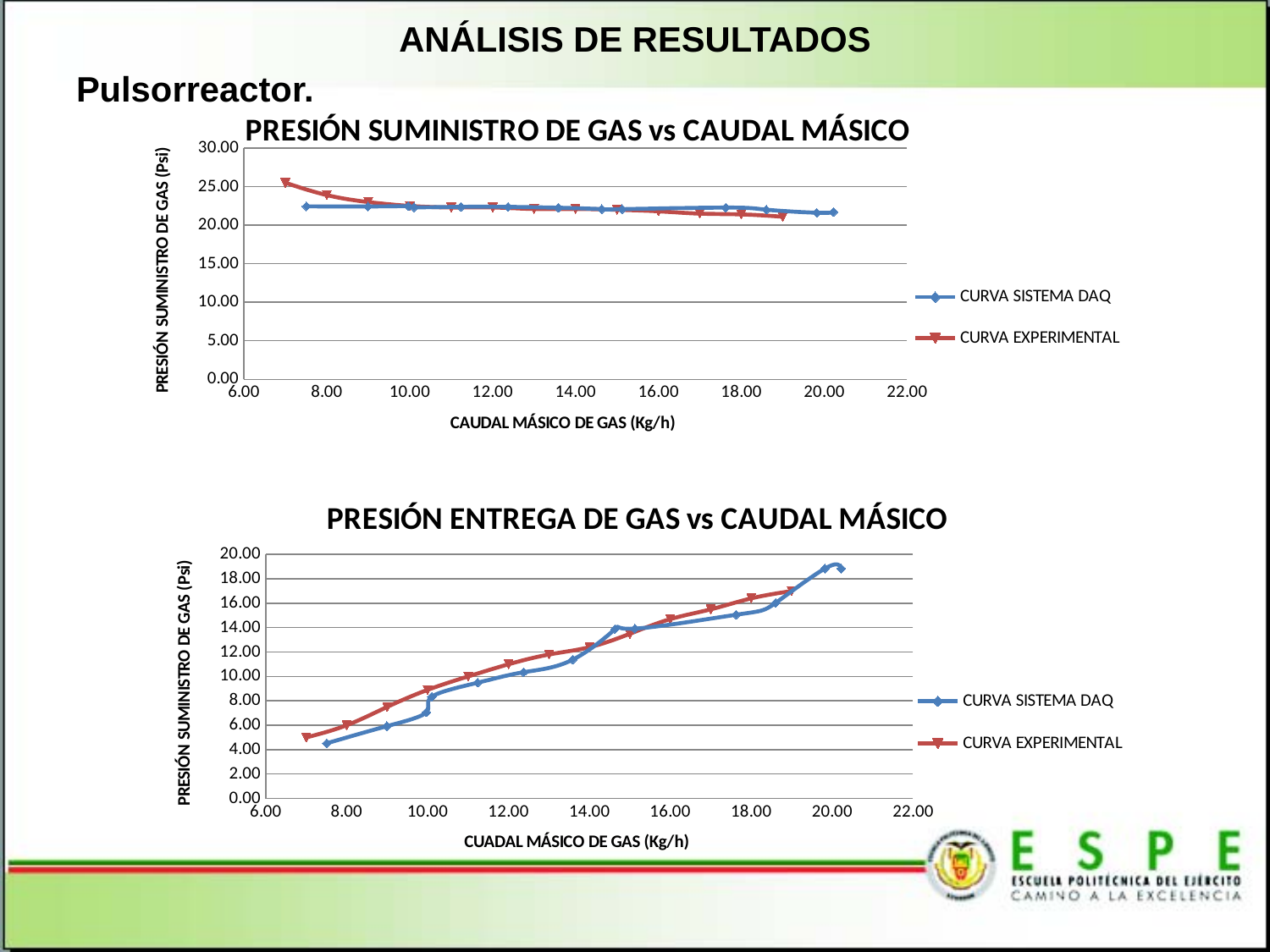
What kind of chart is the bottom chart, 'PRESIÓN ENTREGA DE GAS vs CAUDAL MÁSICO'? Line chart In the bottom chart, is the value for CURVA EXPERIMENTAL at 7.00 Kg/h greater or less than 8.00? less In the bottom chart, at 9.00 Kg/h, which series has the higher value: CURVA SISTEMA DAQ or CURVA EXPERIMENTAL? CURVA EXPERIMENTAL What is the y-axis label of the top chart? PRESIÓN SUMINISTRO DE GAS (Psi) What kind of chart is the top chart, 'PRESIÓN SUMINISTRO DE GAS vs CAUDAL MÁSICO'? Line chart In the bottom chart, is the value for CURVA SISTEMA DAQ at 20.00 Kg/h greater or less than 16.00? greater In the top chart, 'PRESIÓN SUMINISTRO DE GAS vs CAUDAL MÁSICO', do the values of CURVA EXPERIMENTAL rise or fall as the caudal másico increases? Fall In the top chart, is the value for CURVA EXPERIMENTAL at 7.00 Kg/h greater or less than 20.00? greater How many series does the legend of the bottom chart list? 2 How many series does the legend of the top chart list? 2 In the bottom chart, 'PRESIÓN ENTREGA DE GAS vs CAUDAL MÁSICO', do the values of CURVA SISTEMA DAQ rise or fall as the caudal másico increases? Rise